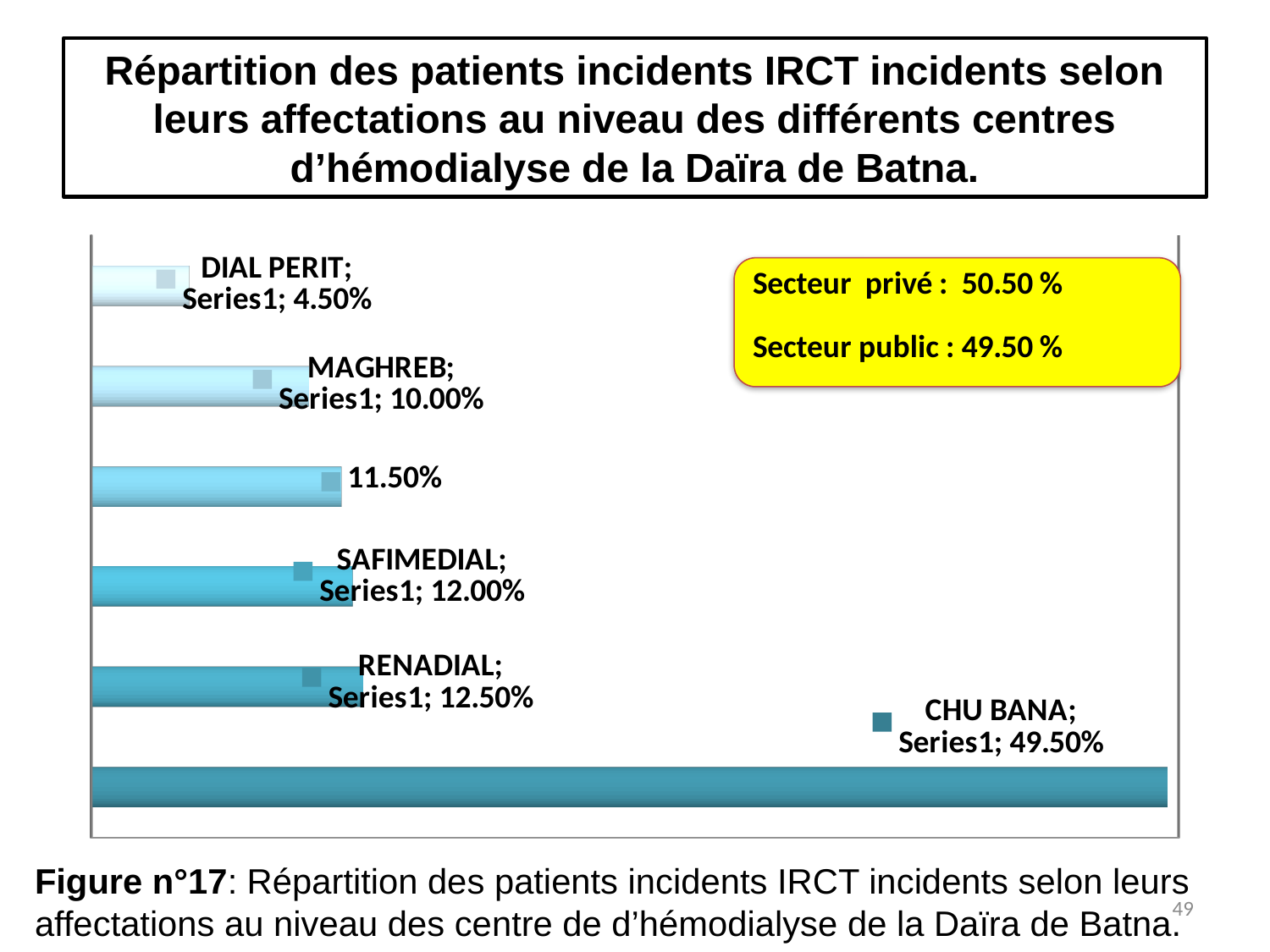
What kind of chart is shown on the slide? bar chart Which centre has the highest value? CHU BANA According to the yellow box on the slide, what is the share of the private sector (Secteur privé)? 50.50 % What is the value for SAFIMEDIAL? 12.00% How many bars are plotted in the chart? 6 What is the difference between the values for CHU BANA and RENADIAL? 37.00% Which centre has the lowest value? DIAL PERIT What is the value for CHU BANA? 49.50% What is the value for RENADIAL? 12.50% What is the value for DIAL PERIT? 4.50% What is the value for MAGHREB? 10.00% Which is larger, the value for MAGHREB or the value for DIAL PERIT? MAGHREB